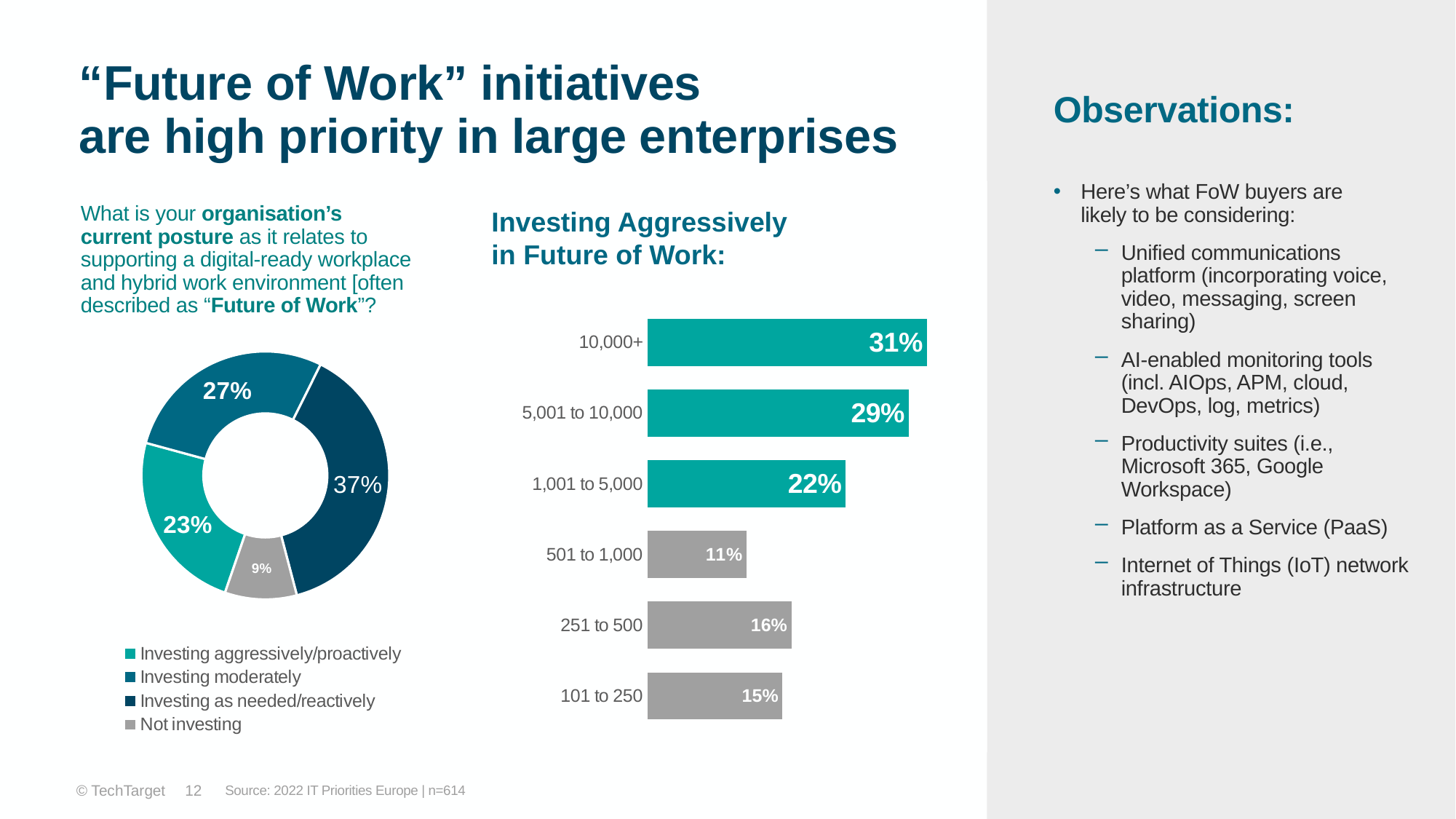
In the donut chart on the left, which category has the smallest share? Not investing In the donut chart on the left, how many categories does the legend list? 4 In the donut chart on the left, what is the difference between the share investing moderately and the share investing aggressively/proactively? 4% In the 'Investing Aggressively in Future of Work' chart, how many categories are shown? 6 In the donut chart on the left, what share of organisations are not investing? 9% In the 'Investing Aggressively in Future of Work' chart, what is the value for 501 to 1,000? 11% In the donut chart on the left, what share of organisations are investing as needed/reactively? 37% In the donut chart on the left, which category has the largest share? Investing as needed/reactively What kind of chart is 'Investing Aggressively in Future of Work'? Bar chart In the 'Investing Aggressively in Future of Work' chart, which category has the lowest value? 501 to 1,000 In the 'Investing Aggressively in Future of Work' chart, what is the value for 10,000+? 31% In the 'Investing Aggressively in Future of Work' chart, which is larger: the value for 251 to 500 or the value for 101 to 250? 251 to 500